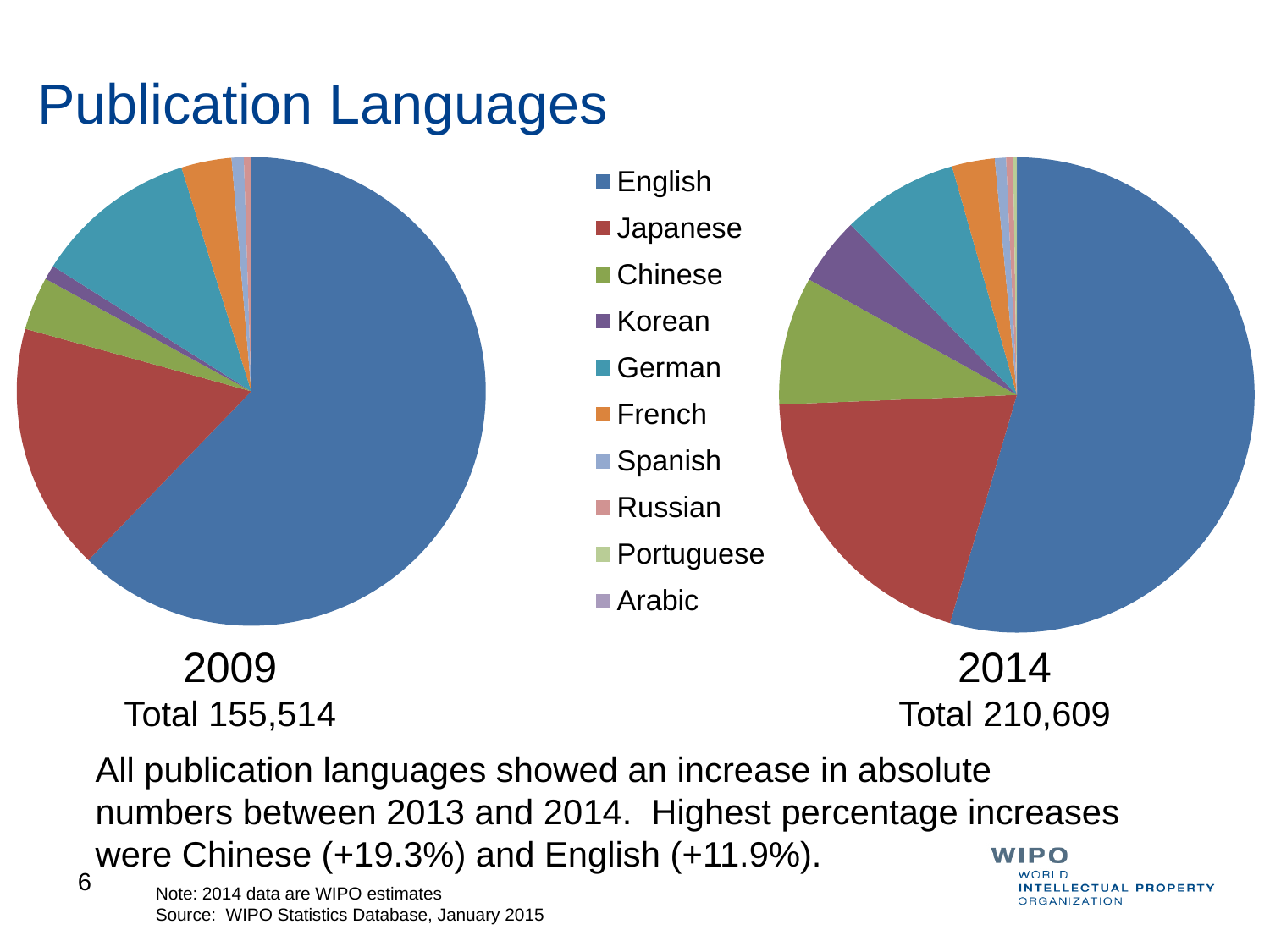
In the 2009 pie chart, which language has the largest share? English What kind of charts are shown on the slide? Pie charts What is the total shown under the 2014 pie chart? 210,609 In the 2014 pie chart, which language has the largest share? English In the 2009 pie chart, which is larger, the Japanese slice or the Chinese slice? Japanese What is the title of the slide containing the pie charts? Publication Languages What is the total shown under the 2009 pie chart? 155,514 In the 2014 pie chart, which is larger, the Japanese slice or the German slice? Japanese By how much does the 2014 total exceed the 2009 total? 55,095 How many languages does the legend list? 10 In the 2009 pie chart, which is larger, the German slice or the French slice? German